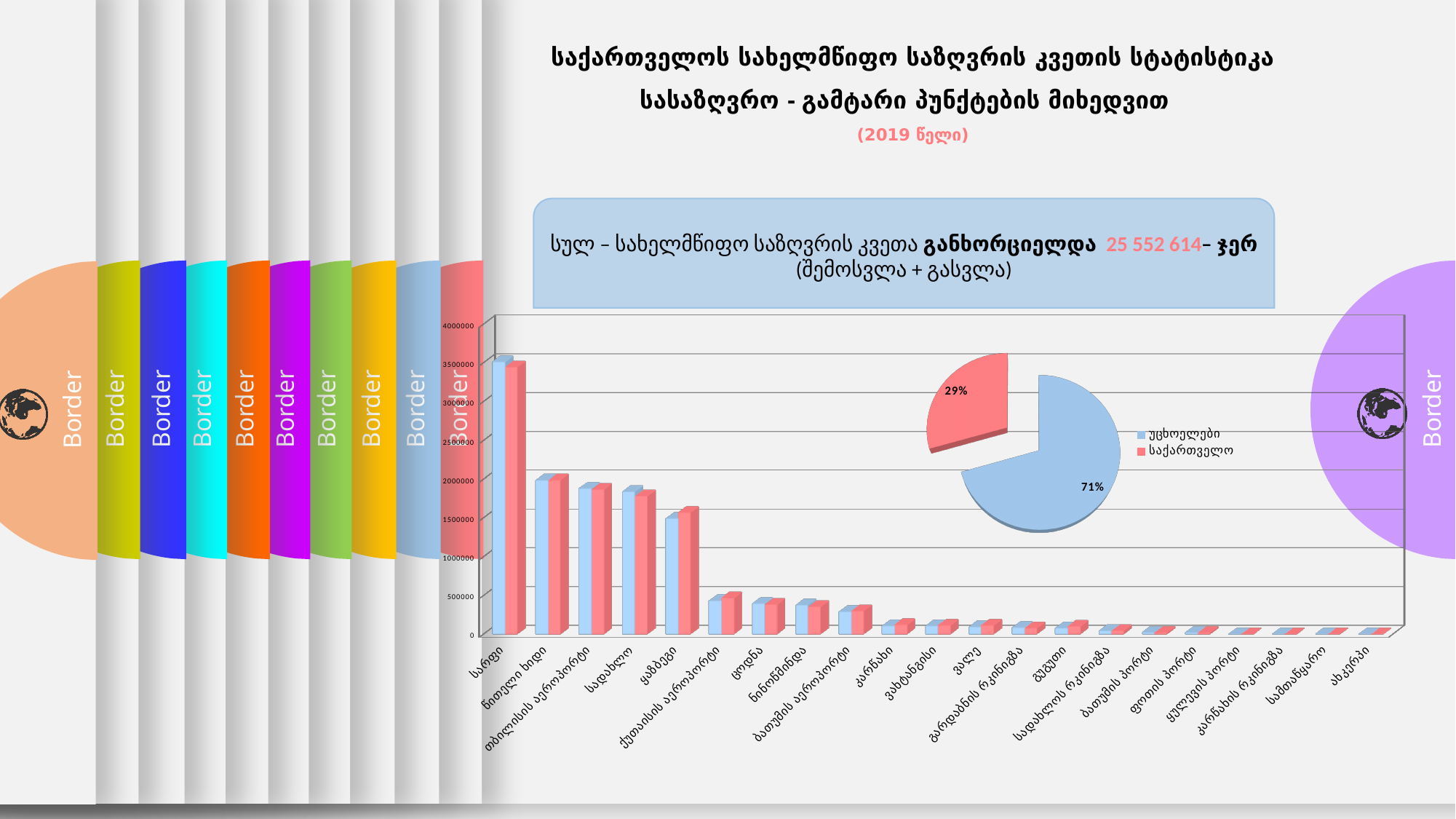
What kind of chart is the chart on the right side of the slide showing 71% and 29%? pie chart In the pie chart, what share is labelled on the blue slice? 71% In the bar chart, which has larger bars, სარფი or ყაზბეგი? სარფი What kind of chart is the chart on the left side of the slide with the Georgian border-crossing point labels? bar chart In the bar chart, which category has the highest bars? სარფი In the bar chart, is the value for სარფი greater or less than 3000000? greater In the pie chart, which legend entry corresponds to the larger slice? უცხოელები In the bar chart, is the value for წითელი ხიდი greater or less than 2500000? less How many entries does the legend of the pie chart list? 2 In the bar chart, is the value for ქუთაისის აეროპორტი greater or less than 1000000? less In the pie chart, what share is labelled on the red slice? 29% In the bar chart, do the values generally rise or fall moving from left to right along the x axis? fall